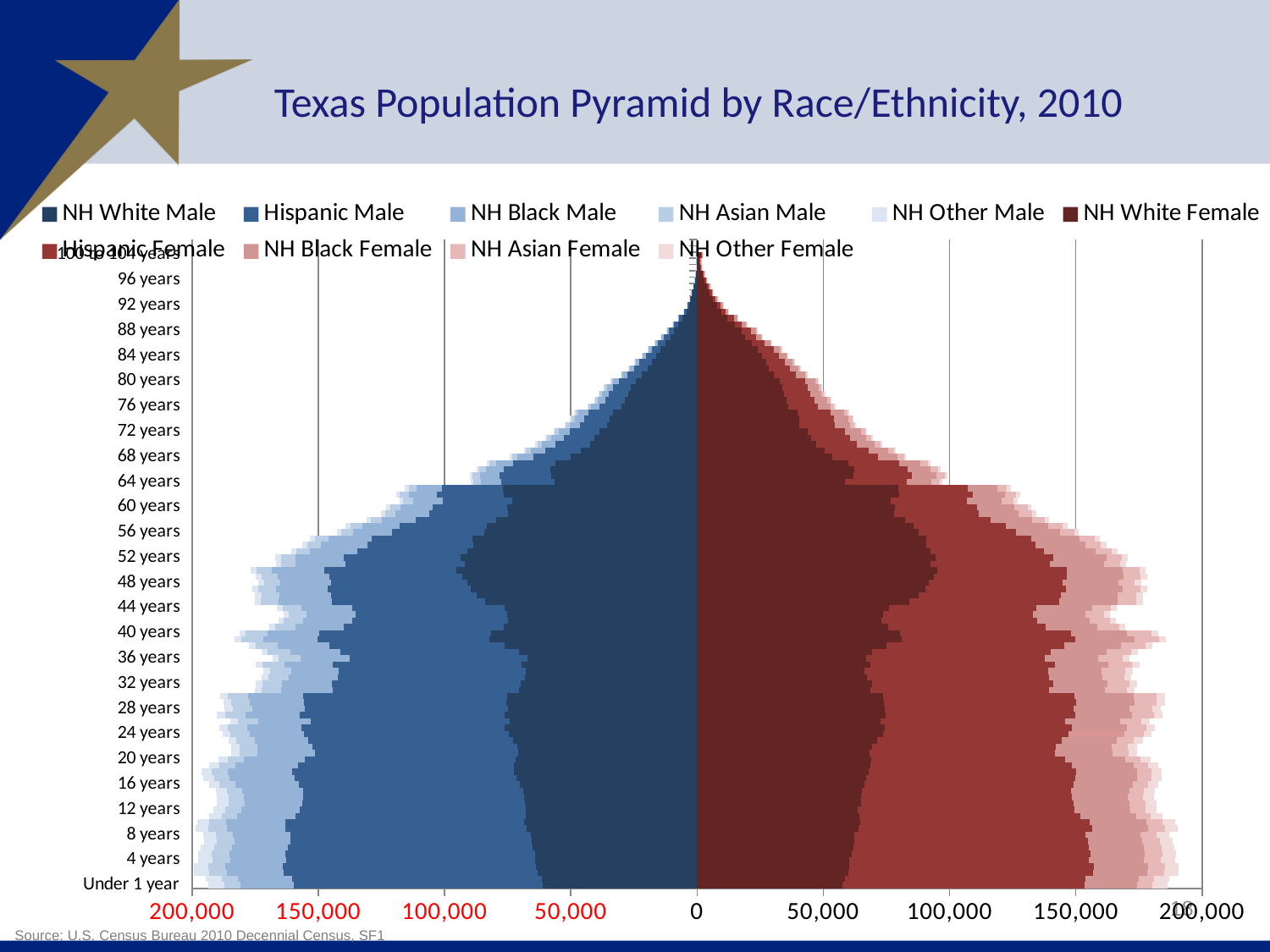
Moving from the youngest age groups at the bottom to the oldest at the top, do the bar lengths generally increase or decrease? Decrease Which has the longer total male bar, 4 years or 64 years? 4 years Which has the longer total female bar, 8 years or 72 years? 8 years Is the total male bar for Under 1 year greater or less than 150,000? greater Is the total male bar for 80 years greater or less than 50,000? less Is the total female bar for 96 years greater or less than 50,000? less What kind of chart is shown on the slide? Bar chart (population pyramid) What is the title of the chart? Texas Population Pyramid by Race/Ethnicity, 2010 How many series does the legend list? 10 Which side of the chart shows the male series, left or right? Left